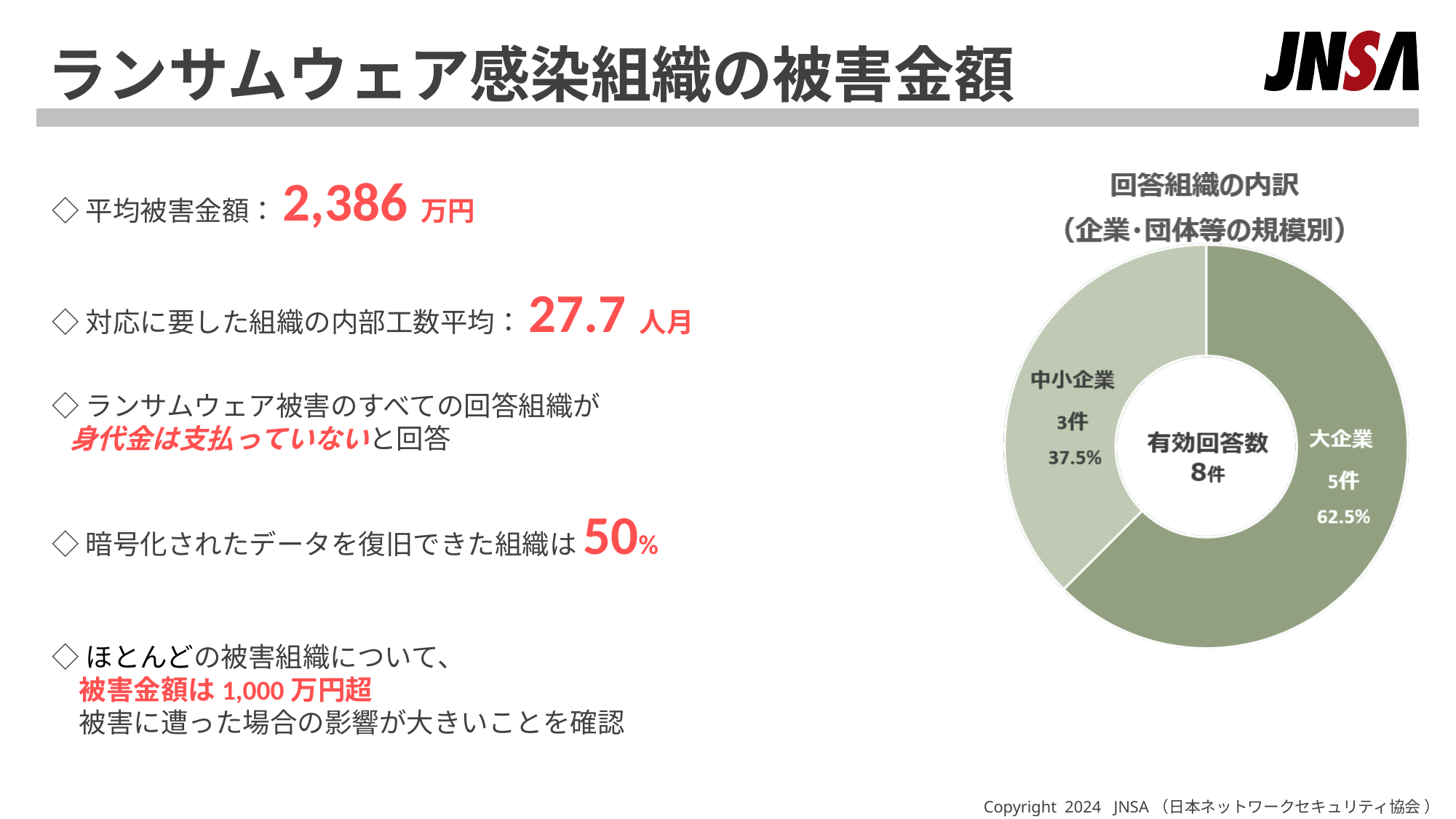
What kind of chart is shown on the slide? Donut (pie) chart Which category has the smallest slice in the chart? 中小企業 What is the difference in number of responses between 大企業 and 中小企業? 2件 What is the title of the chart on the slide? 回答組織の内訳（企業・団体等の規模別） How many categories does the chart show? 2 How many responses (件) does the 中小企業 slice represent? 3件 How many responses (件) does the 大企業 slice represent? 5件 What share of the chart does 中小企業 account for? 37.5% Which category has the largest slice in the chart? 大企業 What is the total number of valid responses (有効回答数) shown in the centre of the chart? 8件 What share of the chart does 大企業 account for? 62.5% Which is larger, the 大企業 slice or the 中小企業 slice? 大企業